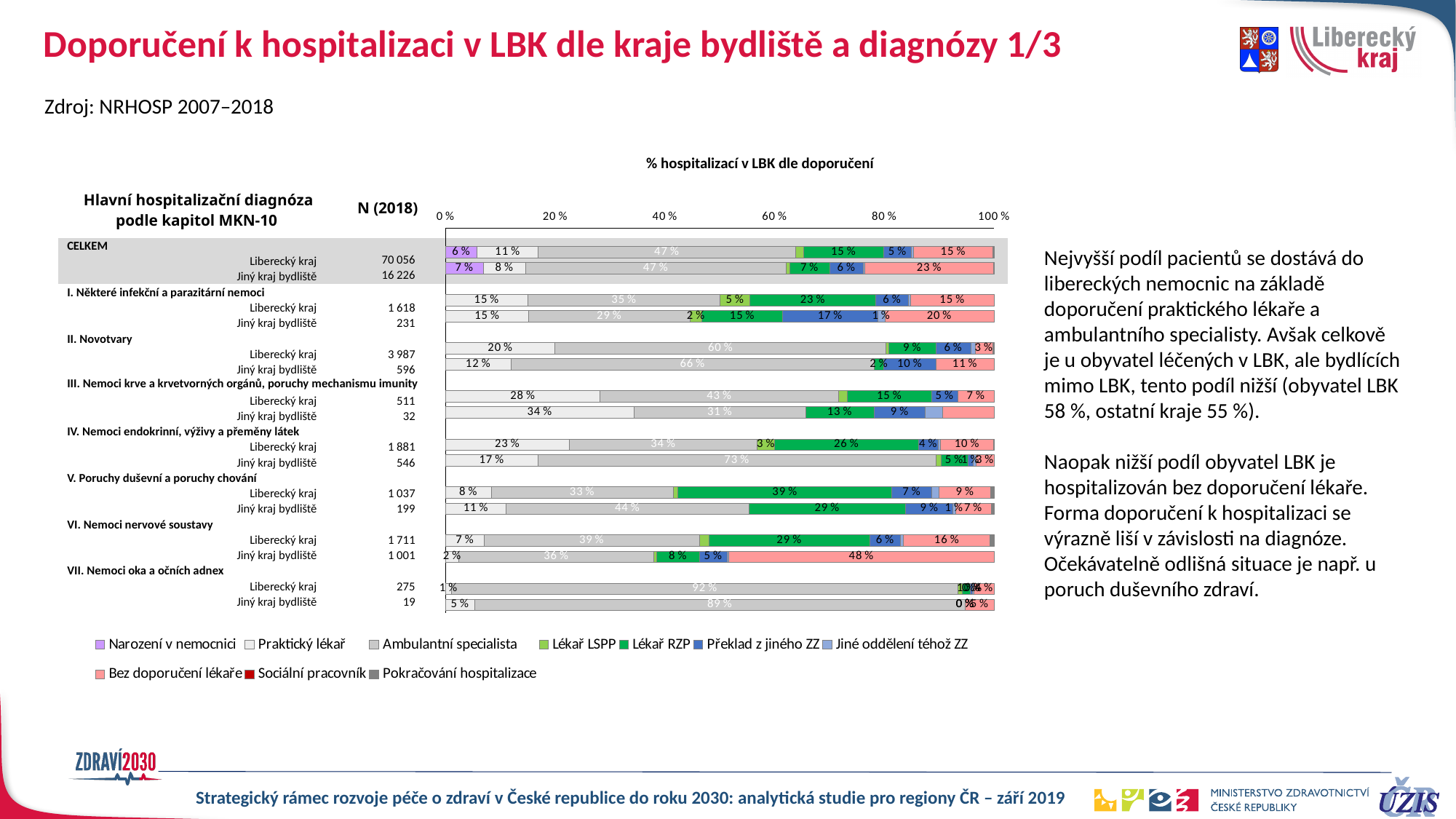
What is the title of the chart? % hospitalizací v LBK dle doporučení How many MKN-10 diagnosis chapters (excluding CELKEM) are shown on the chart? 7 In the CELKEM group, what is the difference in the Bez doporučení lékaře share between Jiný kraj bydliště (23 %) and Liberecký kraj (15 %)? 8 percentage points For V. Poruchy duševní a poruchy chování, Liberecký kraj, what is the share for Lékař RZP? 39 % For VII. Nemoci oka a očních adnex, Liberecký kraj, what is the share for Ambulantní specialista? 92 % For IV. Nemoci endokrinní, výživy a přeměny látek, Jiný kraj bydliště, is the Ambulantní specialista share greater or less than 60 %? greater What type of chart is shown on the slide? Stacked bar chart In the CELKEM group, what share of hospitalizations for Jiný kraj bydliště is Bez doporučení lékaře? 23 % How many series does the chart legend list? 10 In the CELKEM group, which has the larger Lékař RZP share: Liberecký kraj or Jiný kraj bydliště? Liberecký kraj In the CELKEM group, what share of hospitalizations for Liberecký kraj residents is attributed to Ambulantní specialista? 47 % For VI. Nemoci nervové soustavy, Jiný kraj bydliště, what is the share Bez doporučení lékaře? 48 %